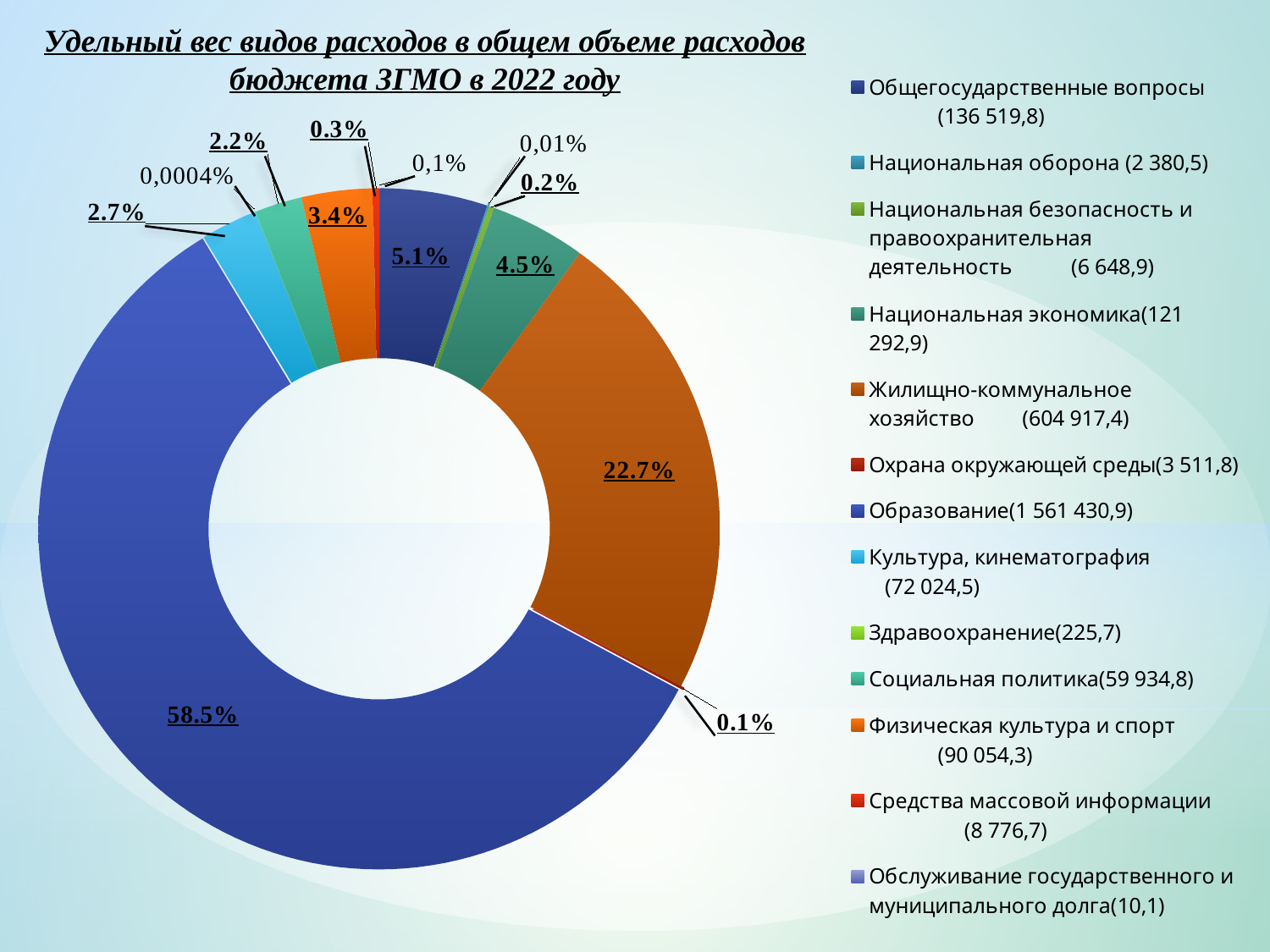
What share of expenditures does Общегосударственные вопросы account for? 5.1% What share of expenditures does Национальная экономика account for? 4.5% What share of expenditures does Образование account for? 58.5% Which category has the largest share of the budget expenditures? Образование How many categories does the legend list? 13 What kind of chart is shown on the slide? Doughnut (pie) chart What amount is shown in the legend for Образование? 1 561 430,9 Which is larger: the share for Жилищно-коммунальное хозяйство or for Национальная экономика? Жилищно-коммунальное хозяйство What share of expenditures does Культура, кинематография account for? 2.7% What share of expenditures does Жилищно-коммунальное хозяйство account for? 22.7% What is the difference in percentage points between the shares of Образование and Жилищно-коммунальное хозяйство? 35.8% What share of expenditures does Физическая культура и спорт account for? 3.4%